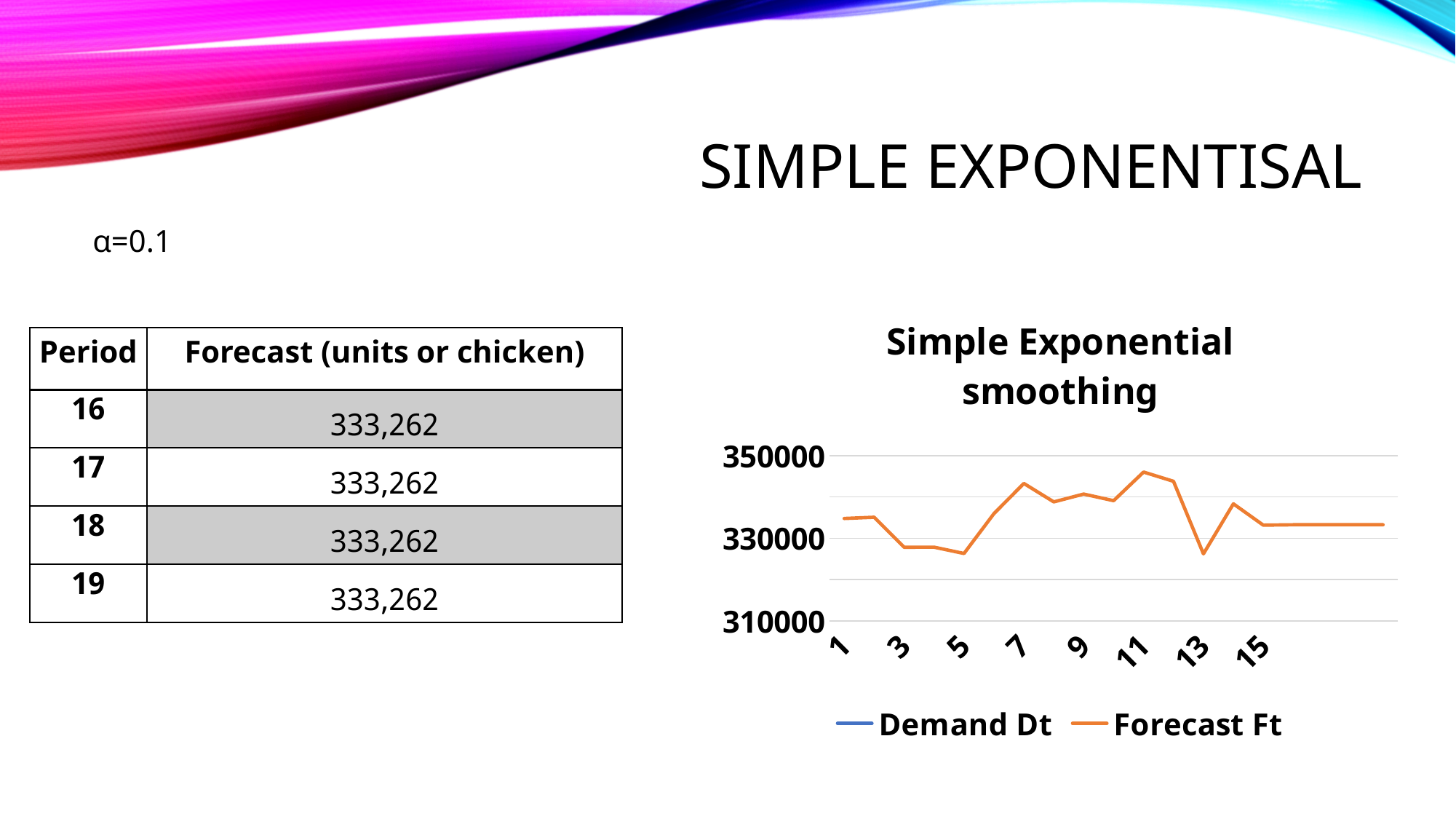
Is the Forecast Ft value at period 1 greater or less than 330000? greater Which is larger, the Forecast Ft value at period 7 or at period 3? period 7 What kind of chart is shown on the slide? line chart Is the Forecast Ft value at period 5 greater or less than 330000? less Does the Forecast Ft line rise or fall between period 11 and period 13? fall Is the Forecast Ft value at period 13 greater or less than 330000? less Does the Forecast Ft line rise or fall between period 5 and period 7? rise At which period does the Forecast Ft line reach its highest value? 11 What are the two series named in the chart legend? Demand Dt and Forecast Ft How many series does the chart legend list? 2 What is the title of the chart? Simple Exponential smoothing